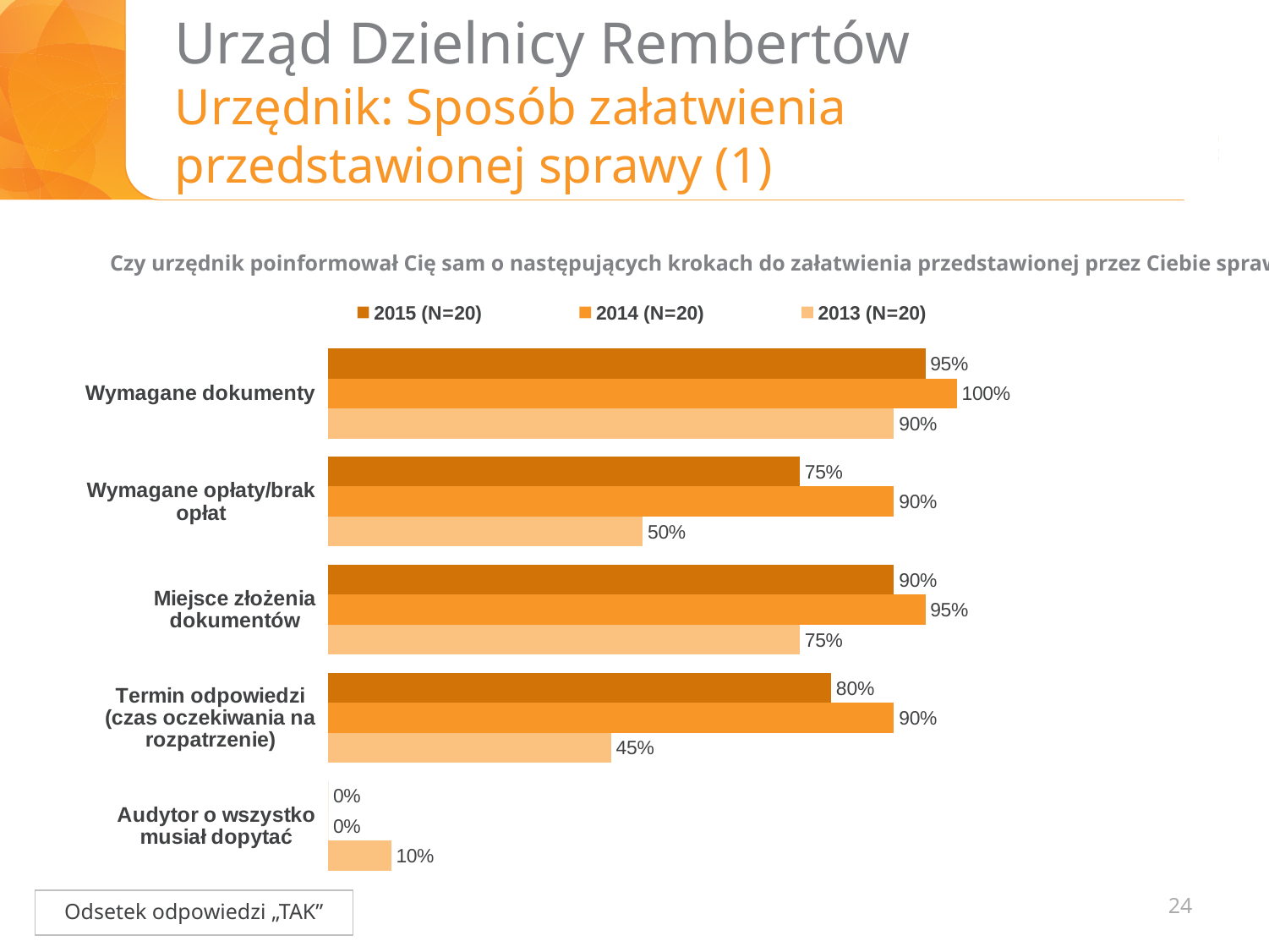
Which category has the highest value in the 2013 (N=20) series? Wymagane dokumenty How many series does the legend list? 3 Which is larger for "Miejsce złożenia dokumentów": the 2015 (N=20) value or the 2014 (N=20) value? 2014 (N=20) What does the box at the bottom left of the slide say the chart shows? Odsetek odpowiedzi „TAK” What is the difference between the 2014 (N=20) and 2013 (N=20) values for "Termin odpowiedzi (czas oczekiwania na rozpatrzenie)"? 45% Which category has the lowest value in the 2015 (N=20) series? Audytor o wszystko musiał dopytać What is the value for "Audytor o wszystko musiał dopytać" in the 2013 (N=20) series? 10% How many categories are shown on the chart? 5 What is the value for "Termin odpowiedzi (czas oczekiwania na rozpatrzenie)" in the 2015 (N=20) series? 80% What is the value for "Wymagane opłaty/brak opłat" in the 2013 (N=20) series? 50% What kind of chart is shown on the slide? Bar chart What is the value for "Wymagane dokumenty" in the 2014 (N=20) series? 100%